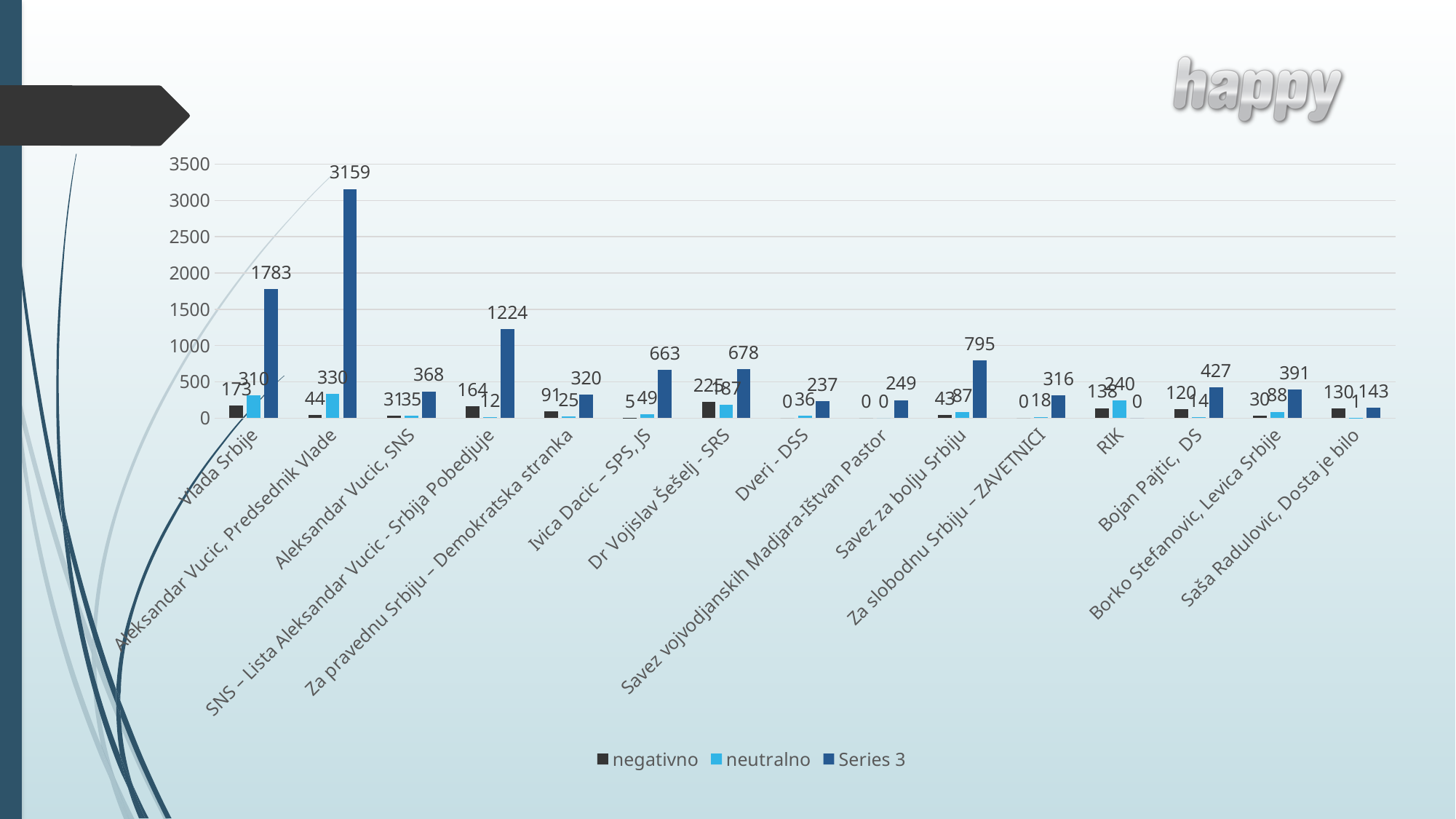
What is the neutralno value for Vlada Srbije? 310 Which category has the highest Series 3 value? Aleksandar Vucic, Predsednik Vlade What is the difference between the Series 3 values for Aleksandar Vucic, Predsednik Vlade and Vlada Srbije? 1376 What is the Series 3 value for Aleksandar Vucic, Predsednik Vlade? 3159 How many series does the legend list? 3 How many categories are shown on the x axis? 15 Is the Series 3 value for SNS – Lista Aleksandar Vucic - Srbija Pobedjuje greater or less than 1000? greater What are the three legend entries of the chart? negativno, neutralno, Series 3 What is the Series 3 value for RIK? 0 What type of chart is shown on the slide? bar chart Which is larger, the Series 3 value for Ivica Dacic – SPS, JS or for Dr Vojislav Šešelj - SRS? Dr Vojislav Šešelj - SRS What is the Series 3 value for Vlada Srbije? 1783